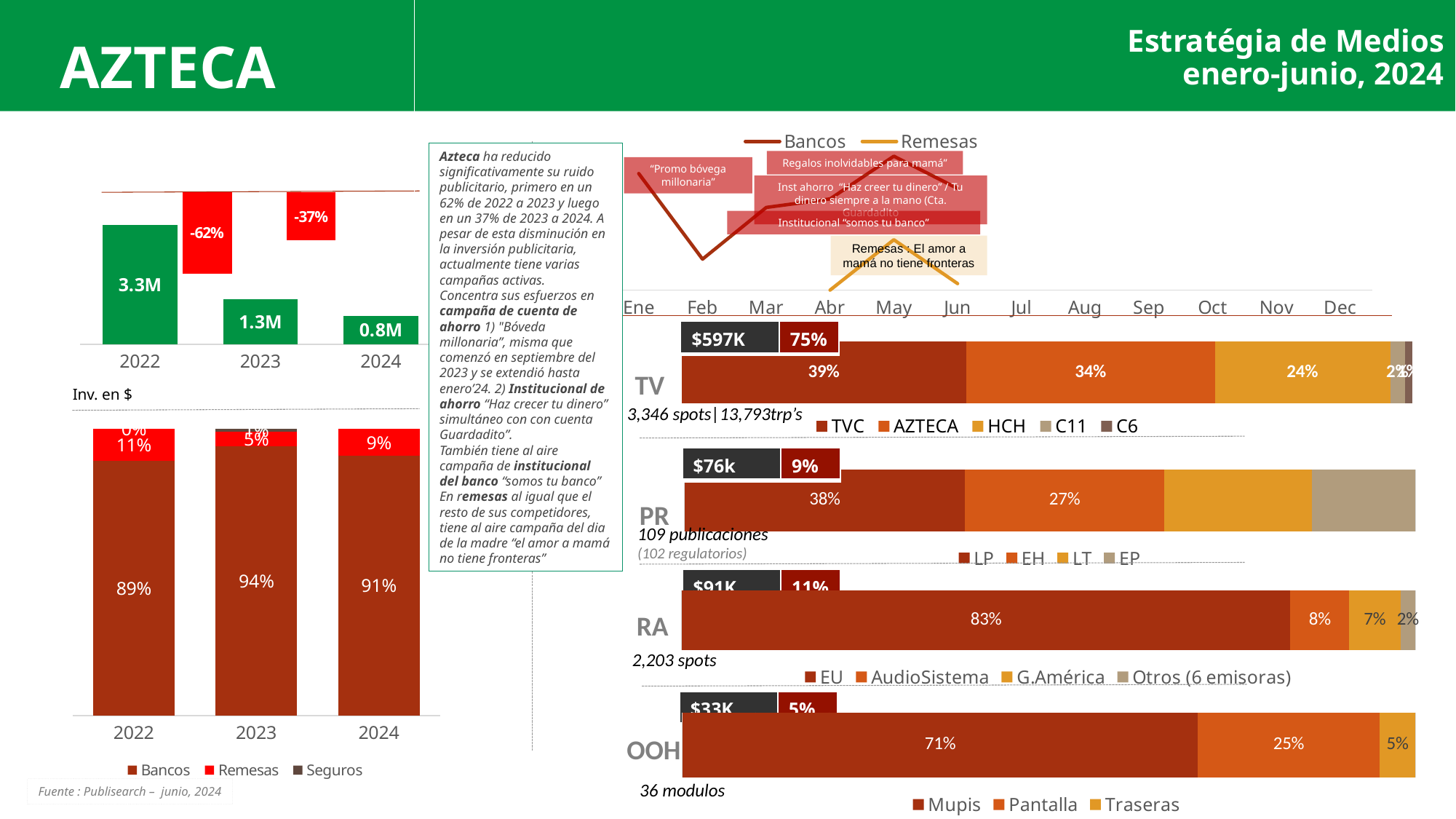
In the OOH stacked bar on the right, what share does Pantalla have? 25% In the 'Inv. en $' bar chart on the left, what is the investment value for 2022? 3.3M In the 'Inv. en $' bar chart on the left, what is the investment value for 2024? 0.8M How many series does the legend of the stacked bar chart at the bottom left list? 3 In the stacked bar chart at the bottom left, what share does Bancos have in 2023? 94% In the 'Inv. en $' bar chart on the left, which year has the highest investment? 2022 In the TV stacked bar on the right, what share does AZTECA have? 34% In the stacked bar chart at the bottom left, what share does Remesas have in 2024? 9% In the RA stacked bar on the right, which station has the largest share? EU In the 'Inv. en $' bar chart on the left, do the investment values rise or fall from 2022 to 2024? fall In the TV stacked bar on the right, what is the difference between the TVC share and the HCH share? 15% In the 'Inv. en $' bar chart on the left, what percentage change is shown between 2022 and 2023? -62%